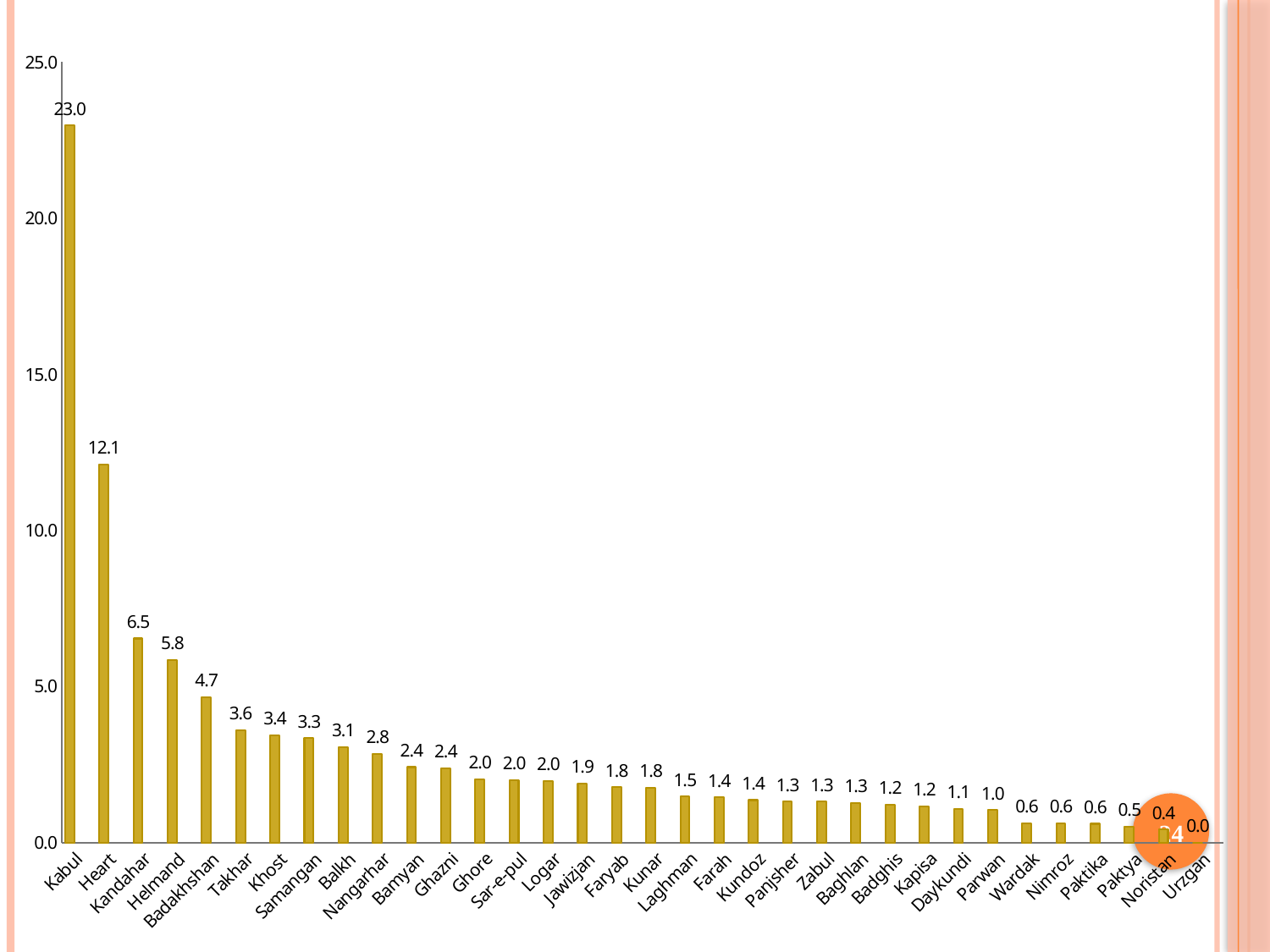
Is the value for Heart greater or less than 10.0? greater What is the value for Helmand? 5.8 Which province has the lowest value? Urzgan Which has a larger value, Takhar or Balkh? Takhar What is the value for Kabul? 23.0 What is the value for Nangarhar? 2.8 What is the difference between the values for Kabul and Heart? 10.9 Which province has the highest value? Kabul What is the value for Laghman? 1.5 What kind of chart is shown on the slide? Bar chart What is the difference between the values for Kandahar and Badakhshan? 1.8 How many provinces are shown on the x axis? 34